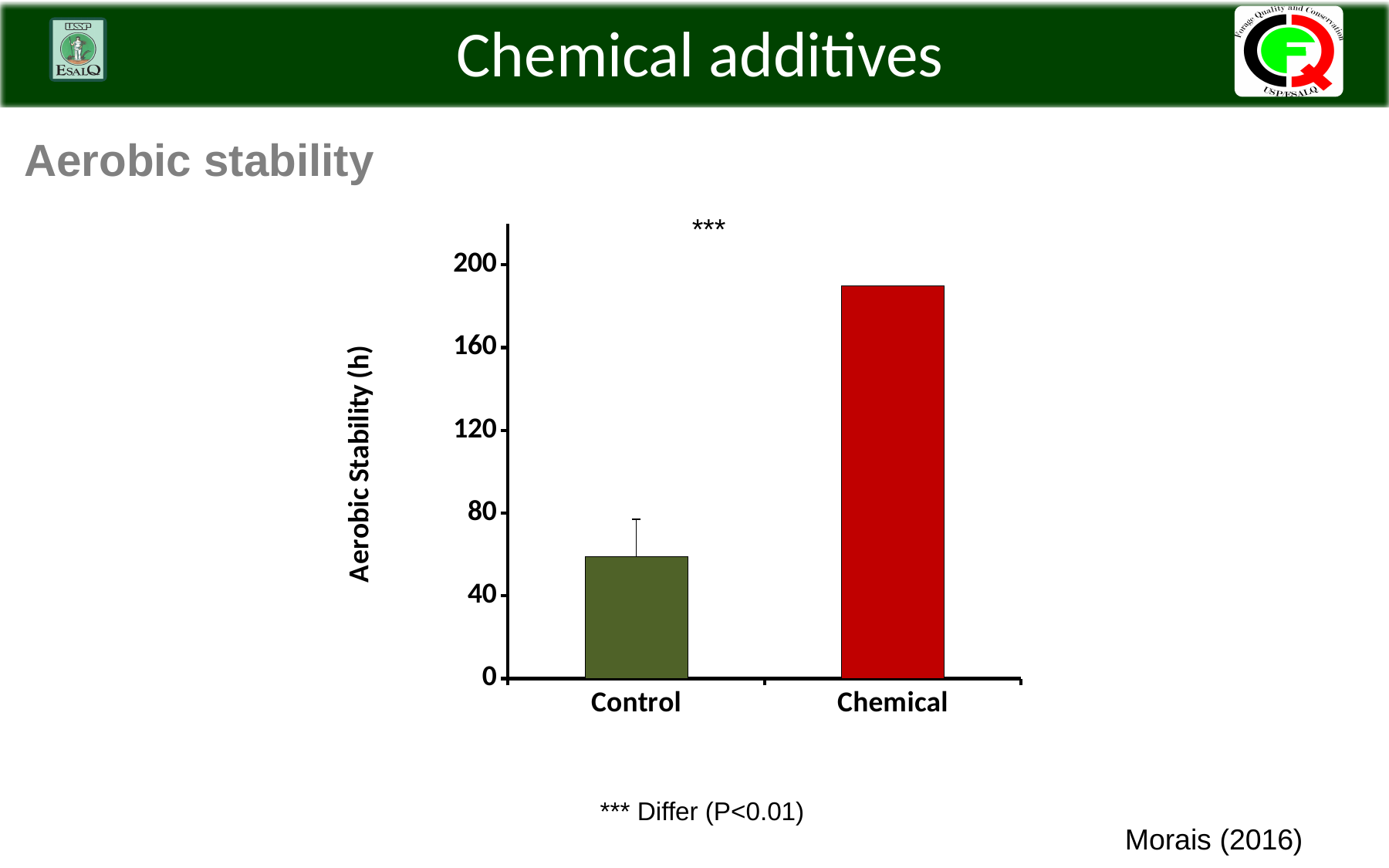
How many categories are shown on the x axis of the chart? 2 Which category has the lowest aerobic stability? Control Is the aerobic stability for Control greater or less than 40? greater Is the aerobic stability for Chemical greater or less than 200? less Is the aerobic stability for Control greater or less than 80? less Which has a larger aerobic stability, Control or Chemical? Chemical What is the label of the y axis of the chart? Aerobic Stability (h) What kind of chart is shown on the slide? bar chart What colour is the bar for Chemical? red Which category has the highest aerobic stability? Chemical